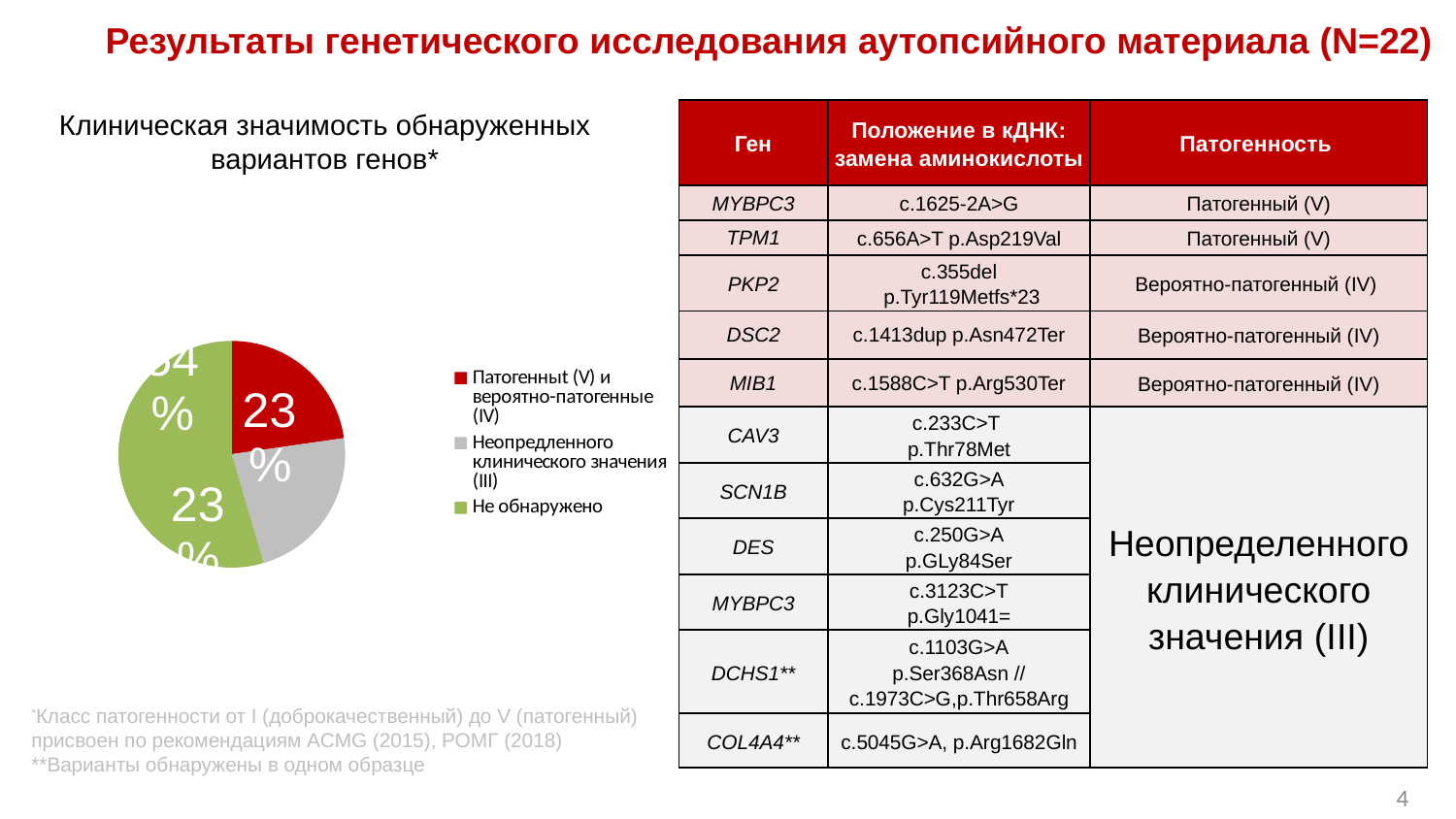
What share of the pie chart is labelled for "Неопределенного клинического значения (III)"? 23% What share of the pie chart is labelled for "Патогенный (V) и вероятно-патогенные (IV)"? 23% Which category takes up the largest slice of the pie chart? Не обнаружено What kind of chart is shown on the slide? Pie chart What is the title of the pie chart? Клиническая значимость обнаруженных вариантов генов* What is the difference between the shares for "Патогенный (V) и вероятно-патогенные (IV)" and "Неопределенного клинического значения (III)"? 0% What colour represents "Не обнаружено" in the pie chart? Green How many slices does the pie chart have? 3 How many entries does the legend of the pie chart list? 3